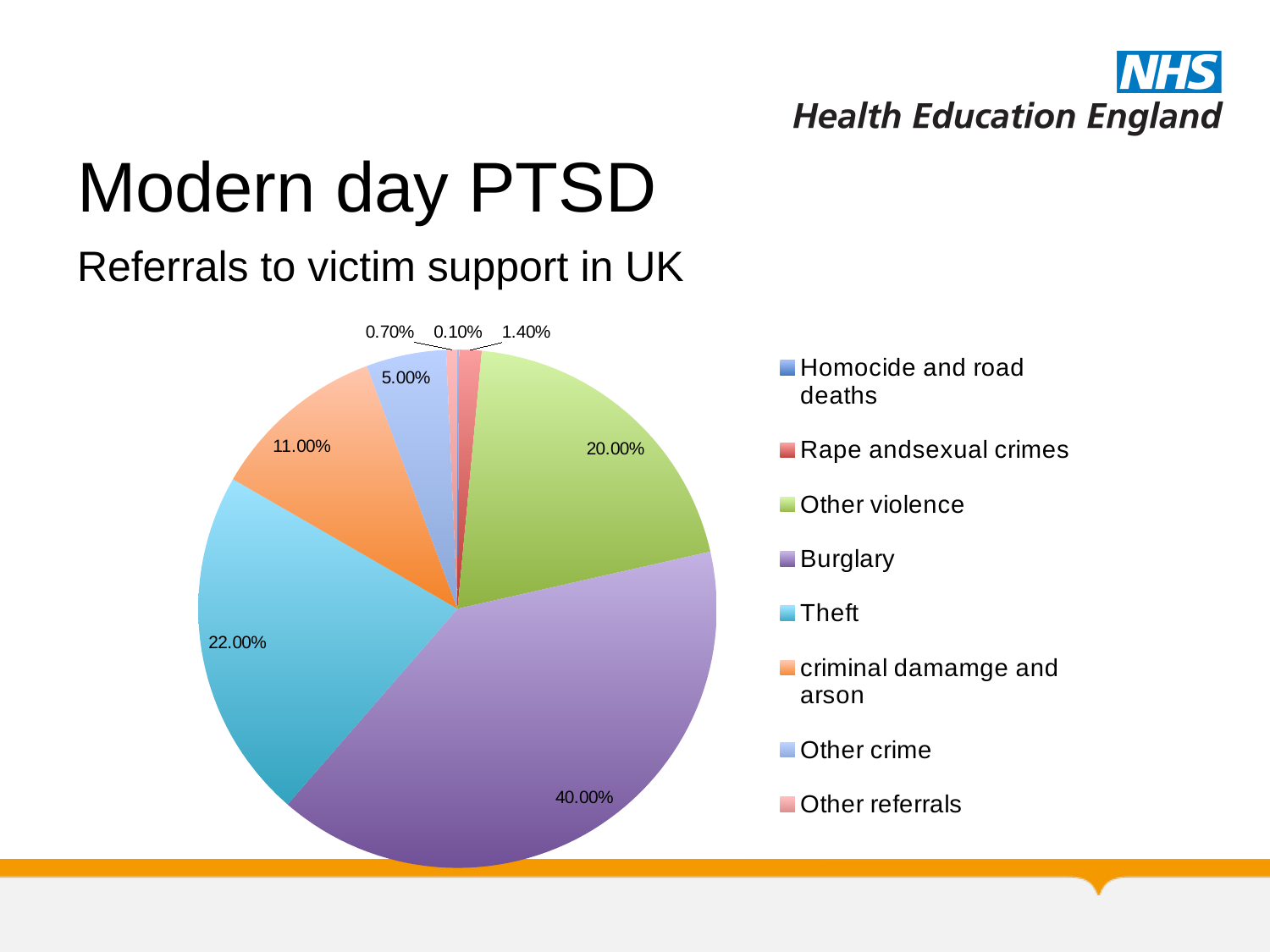
What is the subtitle describing the pie chart's data? Referrals to victim support in UK How many categories does the pie chart show? 8 What percentage of referrals is for Theft? 22.00% What percentage of referrals to victim support is for Burglary? 40.00% What type of chart is shown on the slide? pie chart What percentage of referrals is for criminal damage and arson? 11.00% What percentage of referrals is for Other violence? 20.00% What is the difference between the Burglary share and the Theft share? 18.00% Which has a larger share of referrals, Theft or Other violence? Theft What is the difference between the Other violence share and the criminal damage and arson share? 9.00% What percentage of referrals is for Other crime? 5.00% Which category has the largest share of referrals? Burglary